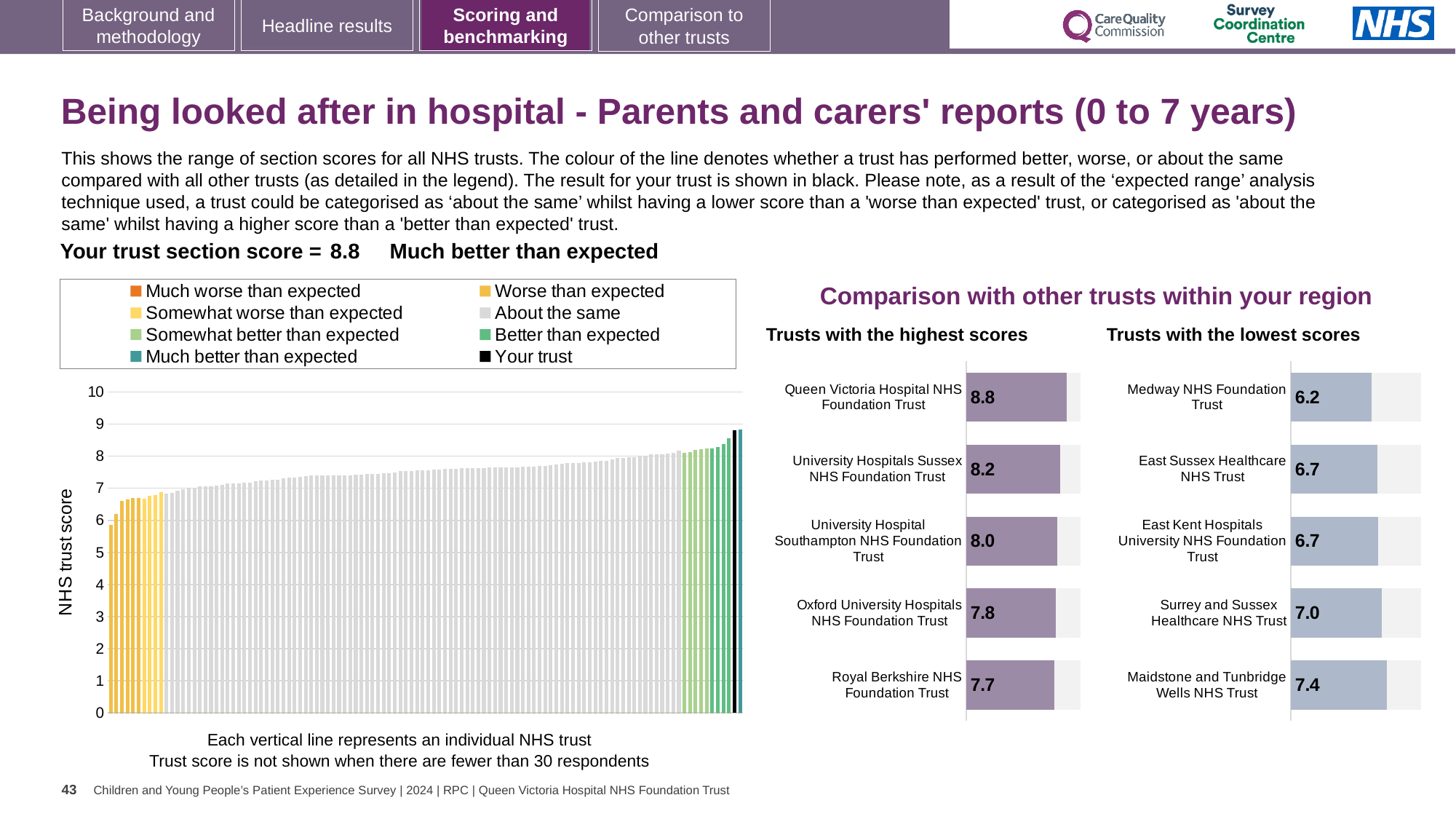
In the 'Trusts with the lowest scores' chart, which trust has the lowest score? Medway NHS Foundation Trust In the 'Trusts with the lowest scores' chart, what is the score for Medway NHS Foundation Trust? 6.2 In the 'Trusts with the lowest scores' chart, which has the higher score: Surrey and Sussex Healthcare NHS Trust or East Sussex Healthcare NHS Trust? Surrey and Sussex Healthcare NHS Trust How many trusts are shown in the 'Trusts with the lowest scores' chart? 5 In the 'Trusts with the highest scores' chart, what is the difference between the scores of Queen Victoria Hospital NHS Foundation Trust and University Hospitals Sussex NHS Foundation Trust? 0.6 In the large 'NHS trust score' chart on the left, do the bar values rise or fall from left to right? rise In the 'Trusts with the highest scores' chart, what is the score for Oxford University Hospitals NHS Foundation Trust? 7.8 In the 'Trusts with the highest scores' chart, what is the score for Queen Victoria Hospital NHS Foundation Trust? 8.8 How many entries does the legend above the large 'NHS trust score' chart list? 8 In the 'Trusts with the highest scores' chart, which trust has the lowest score? Royal Berkshire NHS Foundation Trust In the 'Trusts with the lowest scores' chart, what is the score for Maidstone and Tunbridge Wells NHS Trust? 7.4 In the large 'NHS trust score' chart on the left, is the value for the black 'Your trust' bar greater or less than 8? greater